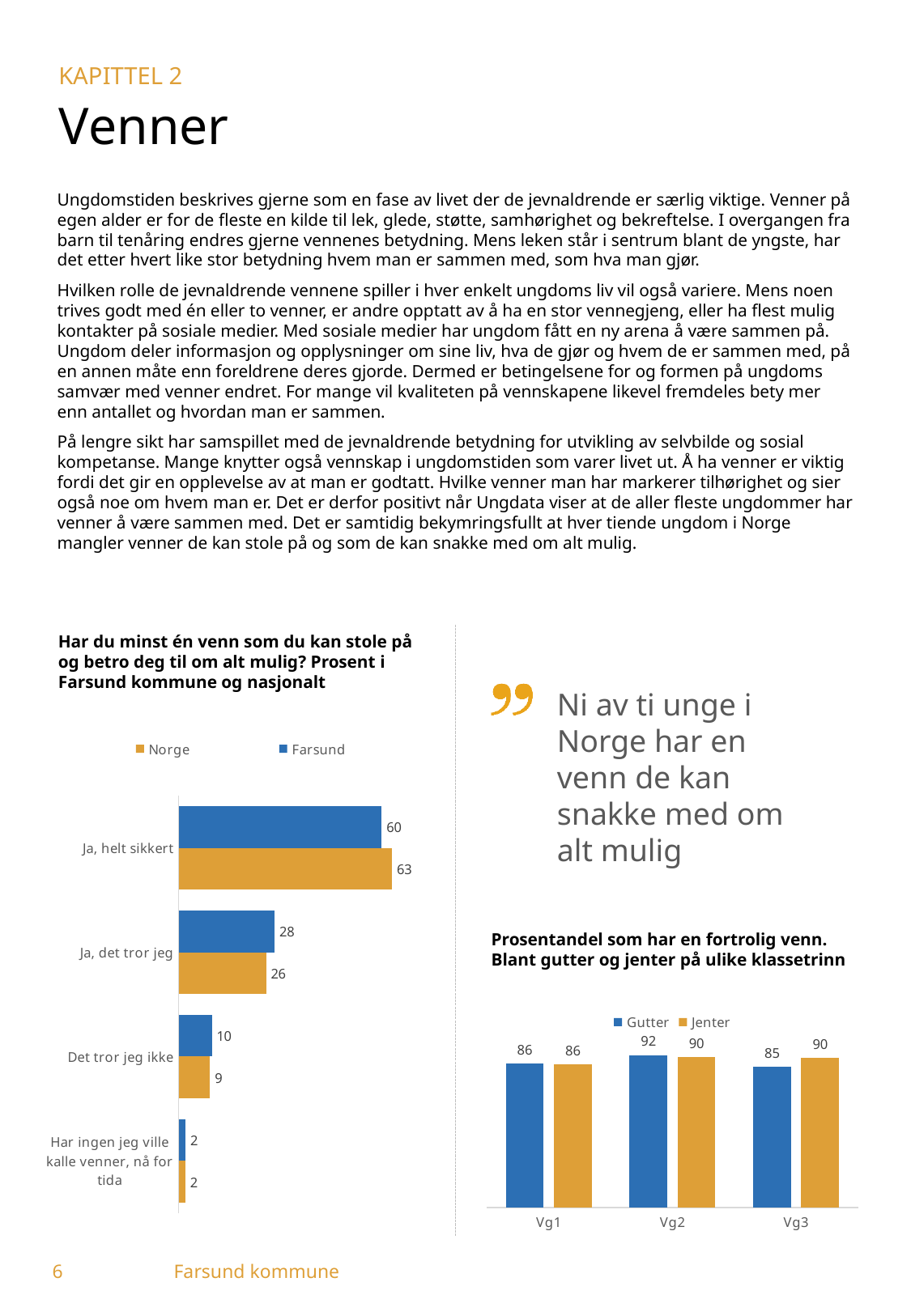
In the right chart (Prosentandel som har en fortrolig venn), what is the value for Gutter at Vg2? 92 In the left chart (Har du minst én venn som du kan stole på...), how many series does the legend list? 2 What type of chart is the left chart (Har du minst én venn som du kan stole på...)? Bar chart In the left chart (Har du minst én venn som du kan stole på...), what is the value for Norge in the category 'Ja, det tror jeg'? 26 In the left chart (Har du minst én venn som du kan stole på...), which category has the highest value for Norge? Ja, helt sikkert In the left chart (Har du minst én venn som du kan stole på...), how many categories are shown? 4 In the left chart (Har du minst én venn som du kan stole på...), which is larger for 'Det tror jeg ikke': Farsund or Norge? Farsund In the right chart (Prosentandel som har en fortrolig venn), what is the value for Jenter at Vg3? 90 In the left chart (Har du minst én venn som du kan stole på...), what is the value for Farsund in the category 'Ja, helt sikkert'? 60 In the right chart (Prosentandel som har en fortrolig venn), what is the difference between Jenter and Gutter at Vg3? 5 In the left chart (Har du minst én venn som du kan stole på...), what is the difference between the Norge and Farsund values for 'Ja, helt sikkert'? 3 In the right chart (Prosentandel som har en fortrolig venn), which series is shown in orange? Jenter